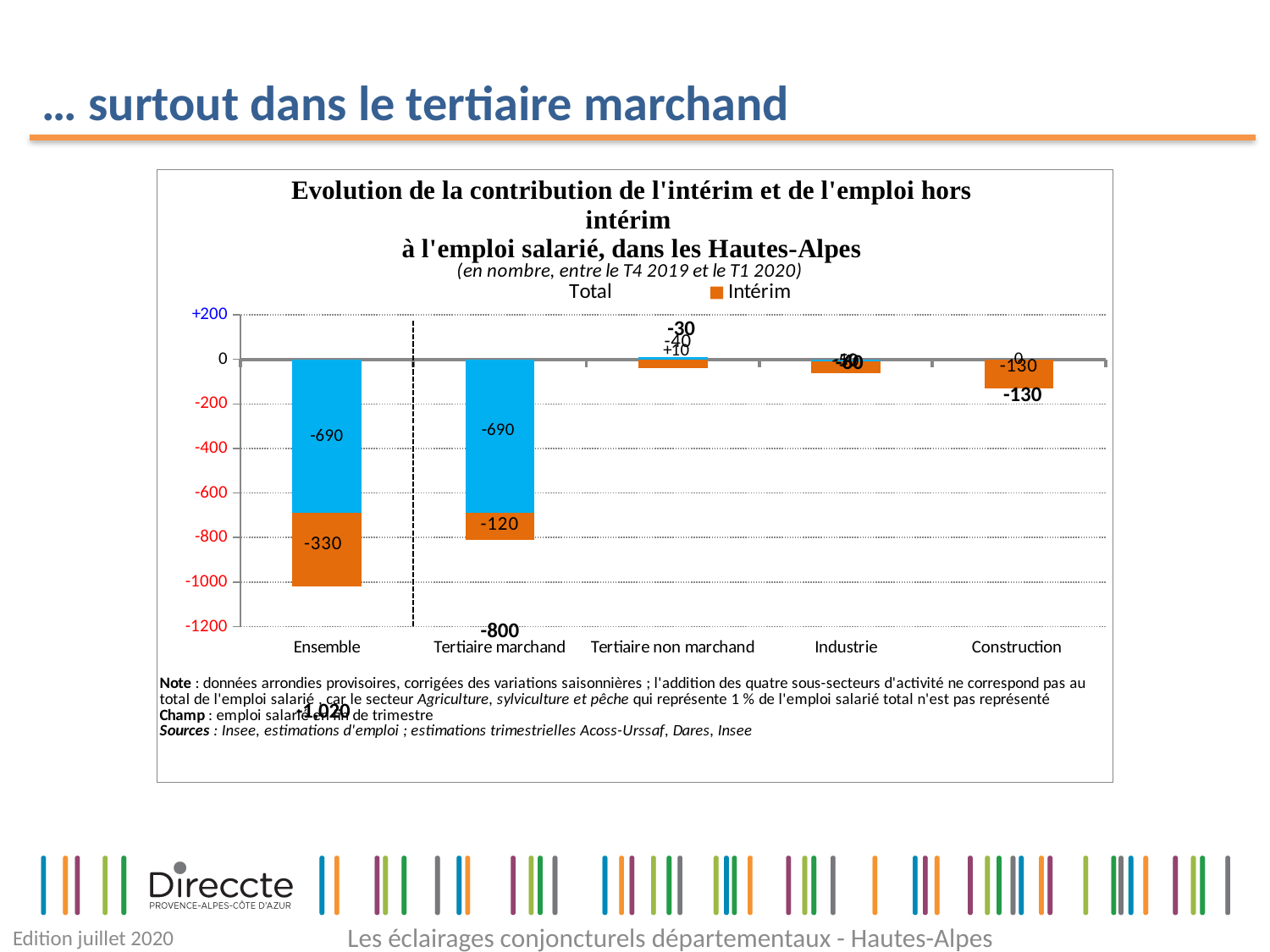
What is the Intérim value for Tertiaire marchand? -120 What is the total shown for Construction? -130 What is the difference between the Intérim value for Ensemble and the Intérim value for Tertiaire marchand? 210 Which has the larger Intérim decline, Ensemble or Construction? Ensemble What is the Intérim value for Ensemble? -330 What is the value of the blue segment for Tertiaire marchand? -690 What kind of chart is this? Stacked bar chart What is the total shown for Tertiaire marchand? -800 Is the total for Tertiaire marchand greater or less than -600? less How many categories are shown on the x axis? 5 Which category has the lowest total? Ensemble What is the total shown for Tertiaire non marchand? -30